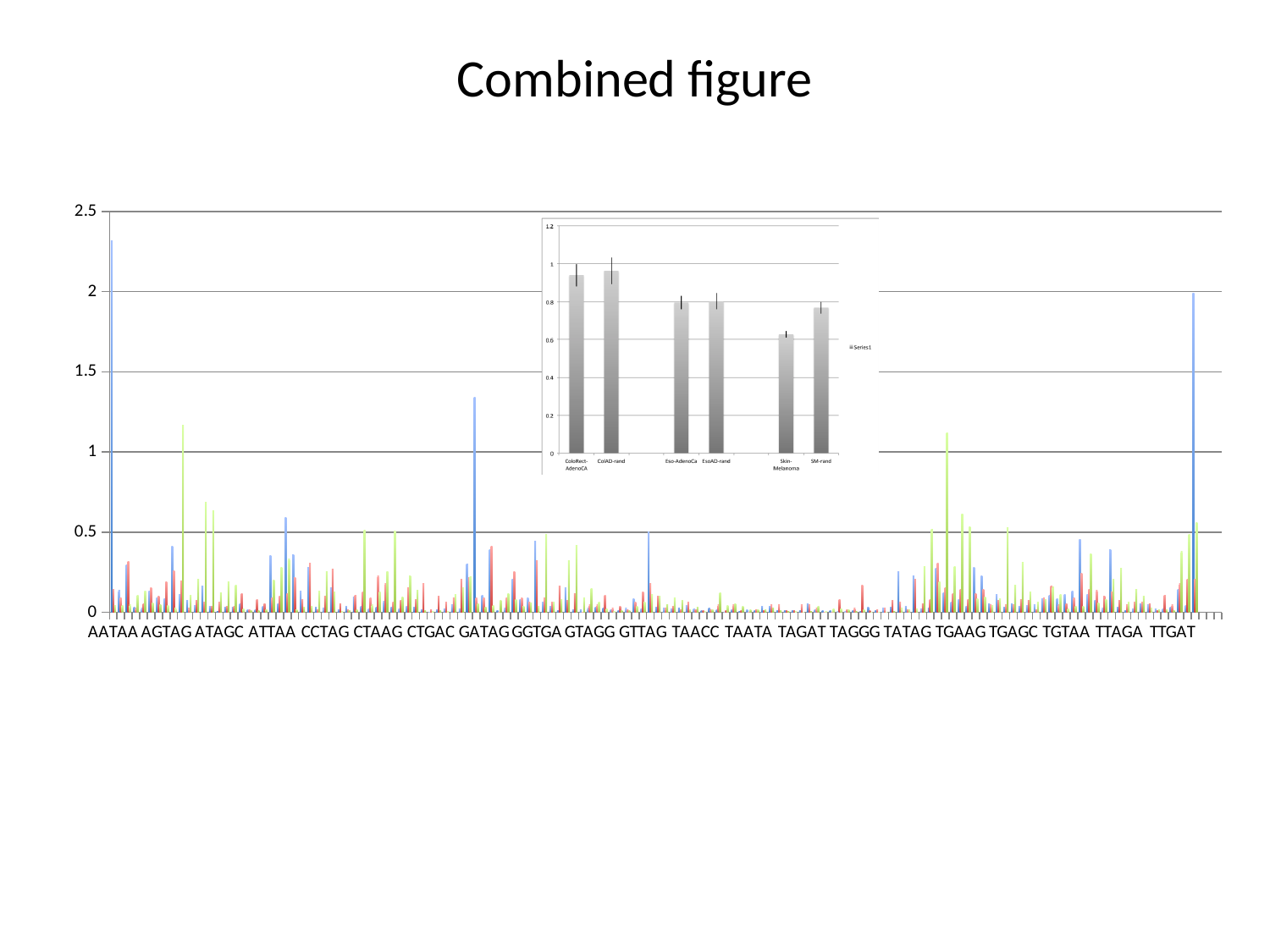
What kind of chart is the smaller inset chart? bar chart In the inset chart, which category has the lowest bar? Skin-Melanoma In the inset chart, is the value for Skin-Melanoma greater or less than 0.8? less In the inset chart, which is larger, the value for Skin-Melanoma or the value for SM-rand? SM-rand In the inset chart, is the value for Eso-AdenoCa greater or less than 1? less In the inset chart, is the value for ColoRect-AdenoCA greater or less than 0.8? greater In the inset chart, what is the legend entry? Series1 In the inset chart, how many series does the legend list? 1 In the inset chart, how many bars are plotted? 6 What kind of chart is the large chart on the slide? bar chart What is the highest value shown on the y axis of the large chart? 2.5 In the inset chart, which is larger, the value for ColoRect-AdenoCA or the value for Eso-AdenoCa? ColoRect-AdenoCA